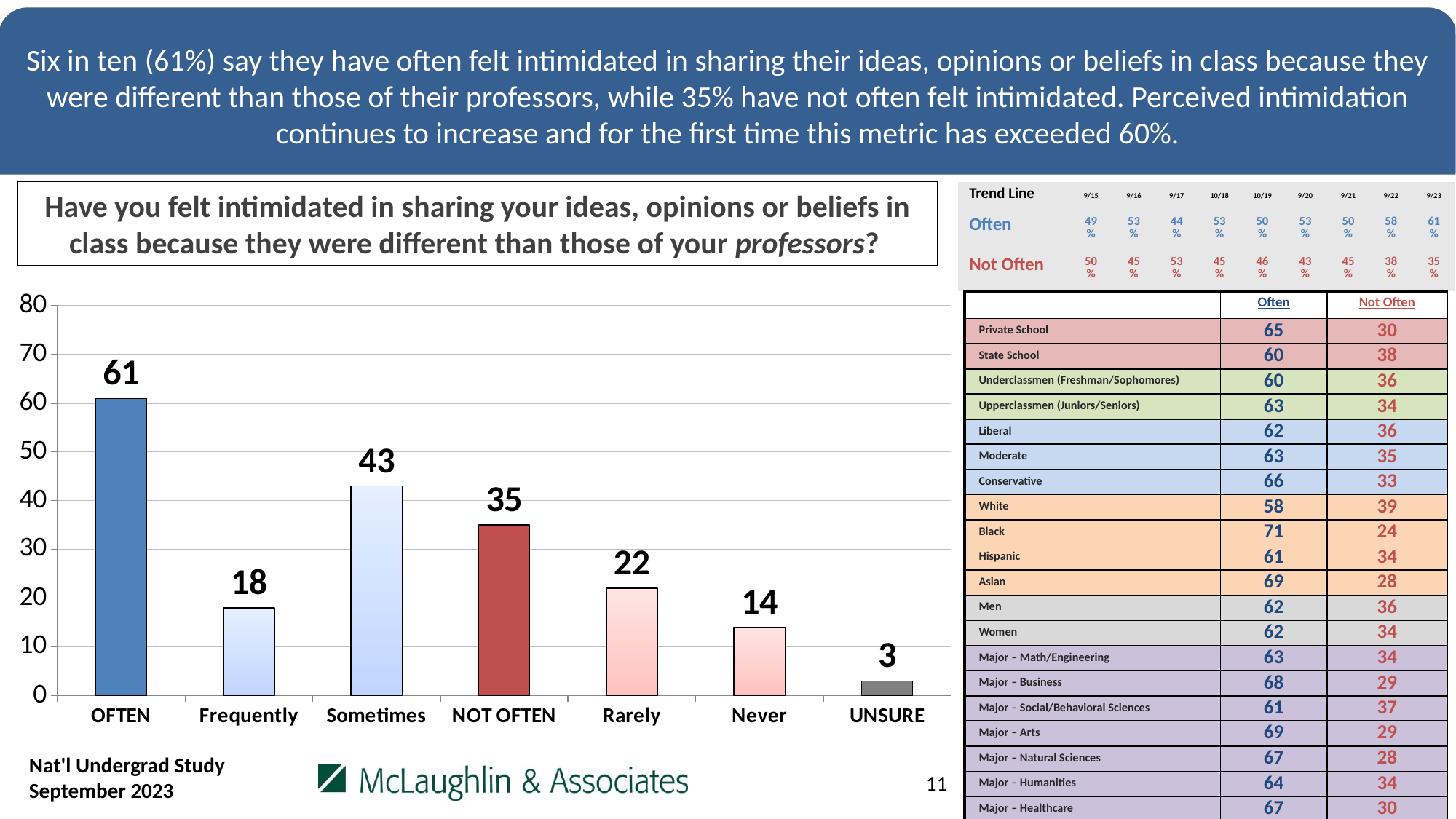
Which category has the highest value in the bar chart? OFTEN Which is larger, the value for Frequently or the value for Rarely? Rarely What is the value for OFTEN in the bar chart? 61 What kind of chart is shown on the slide? Bar chart What is the difference between the values for OFTEN and NOT OFTEN? 26 What is the value for NOT OFTEN in the bar chart? 35 What is the difference between the values for Rarely and Never? 8 What colour is the NOT OFTEN bar in the chart? Red How many categories are shown on the x axis of the bar chart? 7 Which category has the lowest value in the bar chart? UNSURE What is the value for Sometimes in the bar chart? 43 What is the value for UNSURE in the bar chart? 3